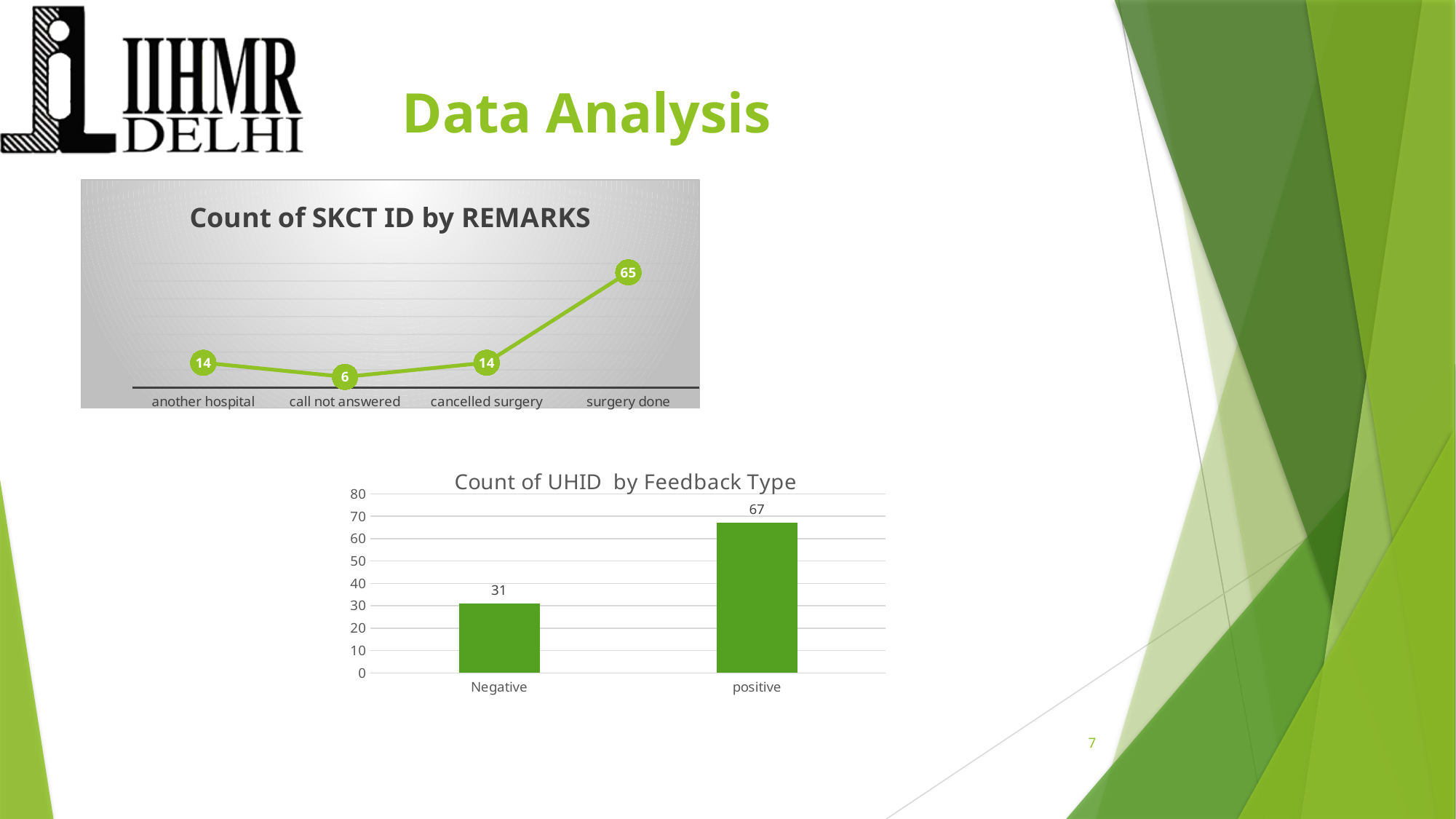
In the 'Count of UHID by Feedback Type' chart, which is larger, 'Negative' or 'positive'? positive What kind of chart is 'Count of SKCT ID by REMARKS'? line chart In the 'Count of SKCT ID by REMARKS' chart, which category has the lowest value? call not answered In the 'Count of SKCT ID by REMARKS' chart, how many categories are shown on the x axis? 4 In the 'Count of SKCT ID by REMARKS' chart, what is the value for 'call not answered'? 6 In the 'Count of UHID by Feedback Type' chart, what is the value for 'Negative'? 31 In the 'Count of SKCT ID by REMARKS' chart, which category has the highest value? surgery done In the 'Count of UHID by Feedback Type' chart, what is the difference between 'positive' and 'Negative'? 36 What kind of chart is 'Count of UHID by Feedback Type'? bar chart In the 'Count of SKCT ID by REMARKS' chart, what is the difference between 'surgery done' and 'cancelled surgery'? 51 In the 'Count of UHID by Feedback Type' chart, what is the value for 'positive'? 67 In the 'Count of SKCT ID by REMARKS' chart, what is the value for 'surgery done'? 65